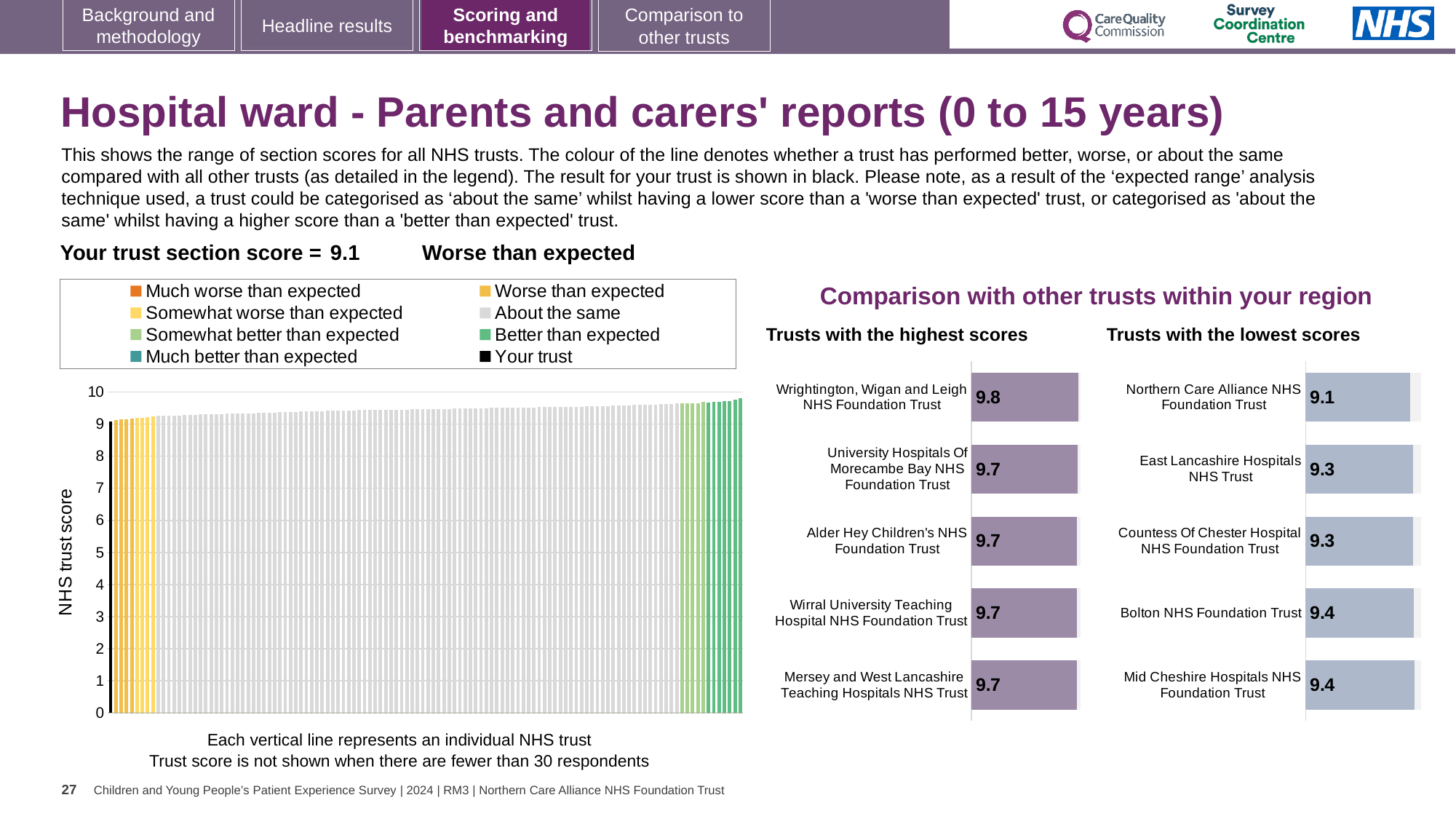
In the 'Trusts with the lowest scores' chart, what is the score for Northern Care Alliance NHS Foundation Trust? 9.1 How many entries does the legend of the 'NHS trust score' chart on the left list? 8 What kind of chart is the 'NHS trust score' chart on the left of the slide? Bar chart In the 'Trusts with the highest scores' chart, which trust has the highest score? Wrightington, Wigan and Leigh NHS Foundation Trust In the 'Trusts with the lowest scores' chart, what is the score for Bolton NHS Foundation Trust? 9.4 In the 'Trusts with the lowest scores' chart, which trust has the lowest score? Northern Care Alliance NHS Foundation Trust In the 'Trusts with the highest scores' chart, what is the score for Wrightington, Wigan and Leigh NHS Foundation Trust? 9.8 In the 'Trusts with the lowest scores' chart, which has the larger score: Bolton NHS Foundation Trust or East Lancashire Hospitals NHS Trust? Bolton NHS Foundation Trust In the 'Trusts with the lowest scores' chart, what is the difference between the scores of Mid Cheshire Hospitals NHS Foundation Trust and Northern Care Alliance NHS Foundation Trust? 0.3 In the 'NHS trust score' chart on the left, do the values rise or fall from left to right along the x axis? Rise In the 'Trusts with the highest scores' chart, what is the difference between the scores of Wrightington, Wigan and Leigh NHS Foundation Trust and Alder Hey Children's NHS Foundation Trust? 0.1 In the 'Trusts with the highest scores' chart, how many trusts are listed? 5